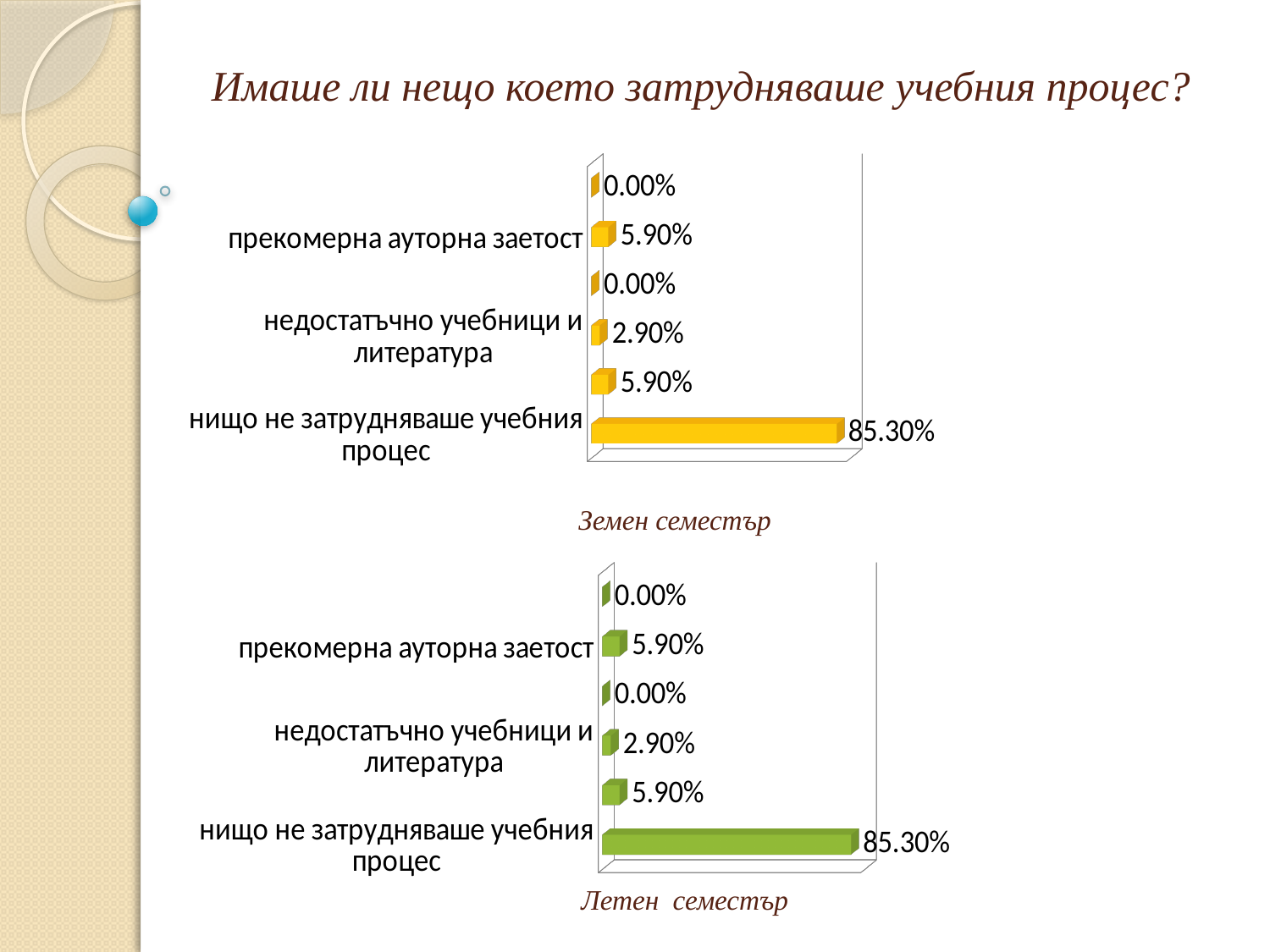
What is the difference between the value for "нищо не затрудняваше учебния процес" in the "Земен семестър" chart and in the "Летен семестър" chart? 0.00% How many bars are plotted in the "Летен семестър" chart? 6 In the "Земен семестър" chart, what is the value for "недостатъчно учебници и литература"? 2.90% In the "Летен семестър" chart, what is the value for "нищо не затрудняваше учебния процес"? 85.30% In the "Земен семестър" chart, what is the value for "нищо не затрудняваше учебния процес"? 85.30% In the "Земен семестър" chart, which labelled category has the highest value? нищо не затрудняваше учебния процес In the "Земен семестър" chart, which is larger: "прекомерна ауторна заетост" or "недостатъчно учебници и литература"? прекомерна ауторна заетост How many charts are shown on the slide? 2 What kind of chart is the "Земен семестър" chart? bar chart In the "Летен семестър" chart, what is the value for "прекомерна ауторна заетост"? 5.90% What colour are the bars in the "Летен семестър" chart? green In the "Летен семестър" chart, what is the difference between "нищо не затрудняваше учебния процес" and "прекомерна ауторна заетост"? 79.40%